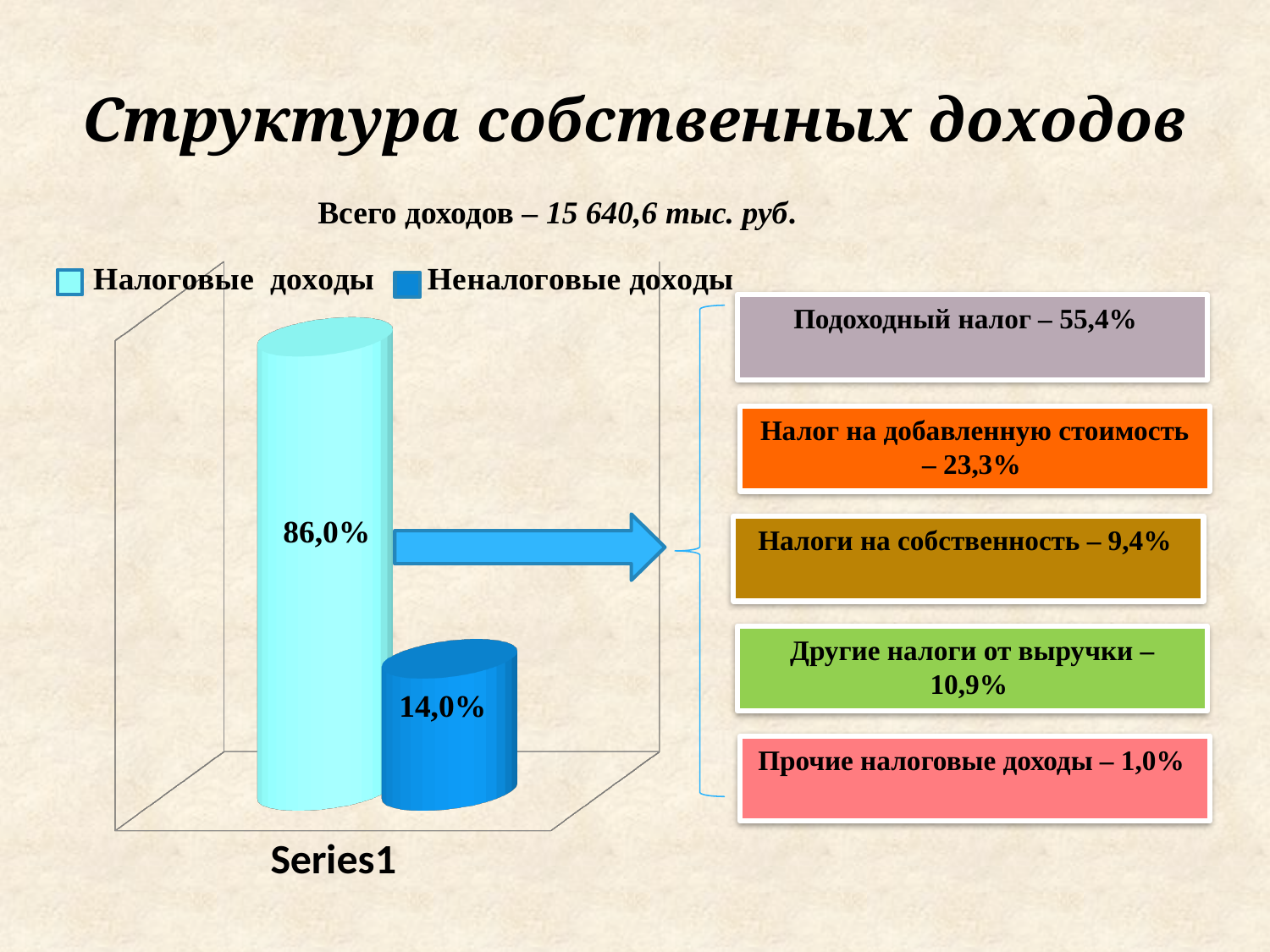
What value is shown for Неналоговые доходы in the chart? 14,0% What is the difference between the values for Налоговые доходы and Неналоговые доходы? 72,0% What value is shown for Налоговые доходы in the chart? 86,0% Which series has the lowest value in the chart? Неналоговые доходы Which legend entry is shown in dark blue in the chart? Неналоговые доходы What kind of chart is shown on the slide? Bar chart How many series does the chart legend list? 2 Which series has the highest value in the chart? Налоговые доходы What is the category label shown under the bars in the chart? Series1 Which series has the higher value in the chart, Налоговые доходы or Неналоговые доходы? Налоговые доходы What is the total of the two values shown in the chart? 100,0%